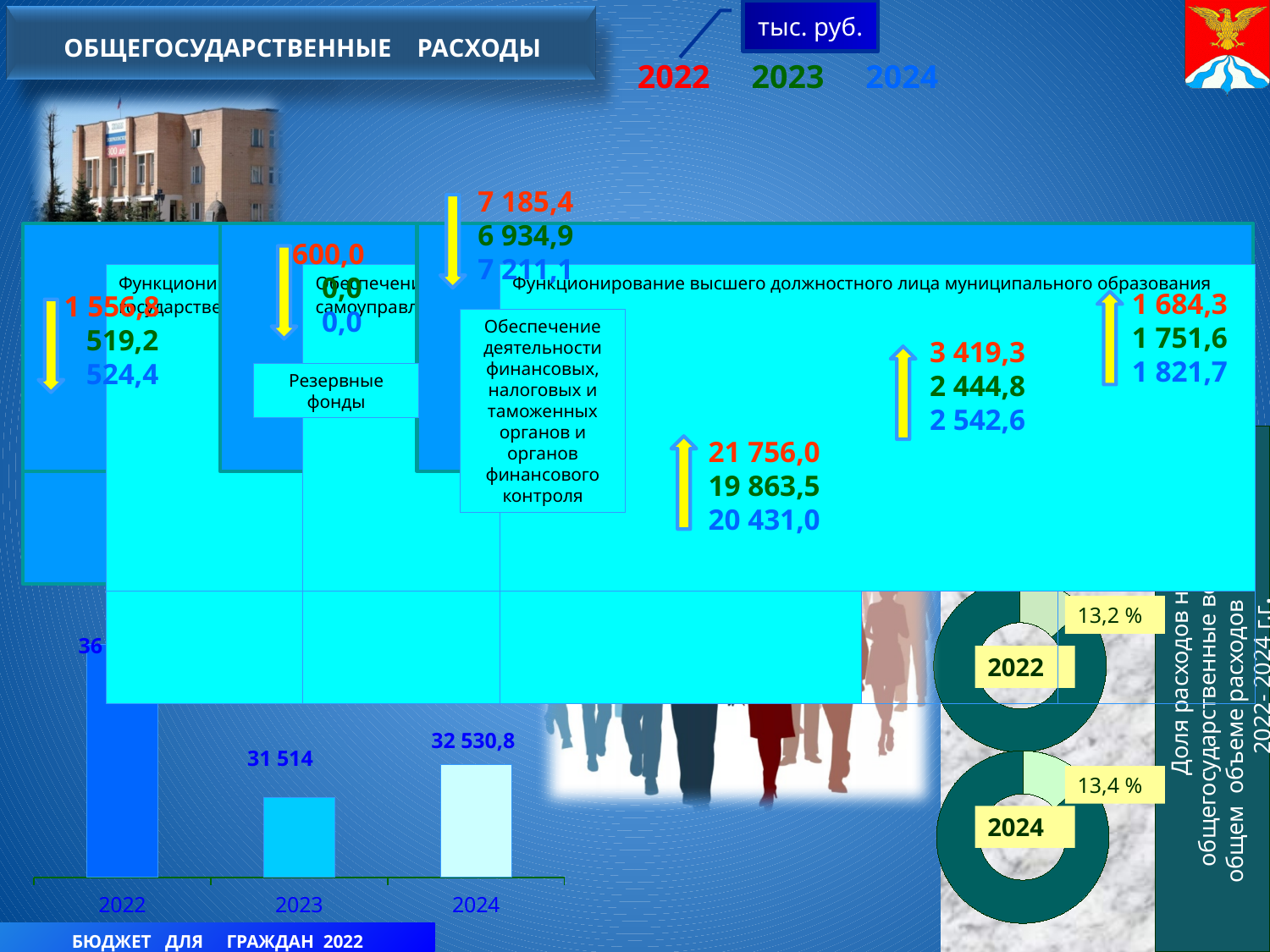
Comparing the donut charts at the bottom right of the slide, which year shows the larger share, 2022 or 2024? 2024 In the bar chart at the bottom left of the slide, which year has the lowest value? 2023 In the bar chart at the bottom left of the slide, what is the value for 2024? 32 530,8 How many bars are shown in the bar chart at the bottom left of the slide? 3 In the bar chart at the bottom left of the slide, does the value rise or fall from 2023 to 2024? rise In the bar chart at the bottom left of the slide, what is the value for 2023? 31 514 In the bar chart at the bottom left of the slide, what is the difference between the values for 2024 and 2023? 1 016,8 What kind of chart is shown at the bottom left of the slide? bar chart In the donut chart labelled 2024 at the bottom right of the slide, what share is shown for the highlighted slice? 13,4 % In the bar chart at the bottom left of the slide, which year has the tallest bar? 2022 In the donut chart labelled 2022 at the bottom right of the slide, what share is shown for the highlighted slice? 13,2 % In the bar chart at the bottom left of the slide, which is larger, the value for 2023 or the value for 2024? 2024